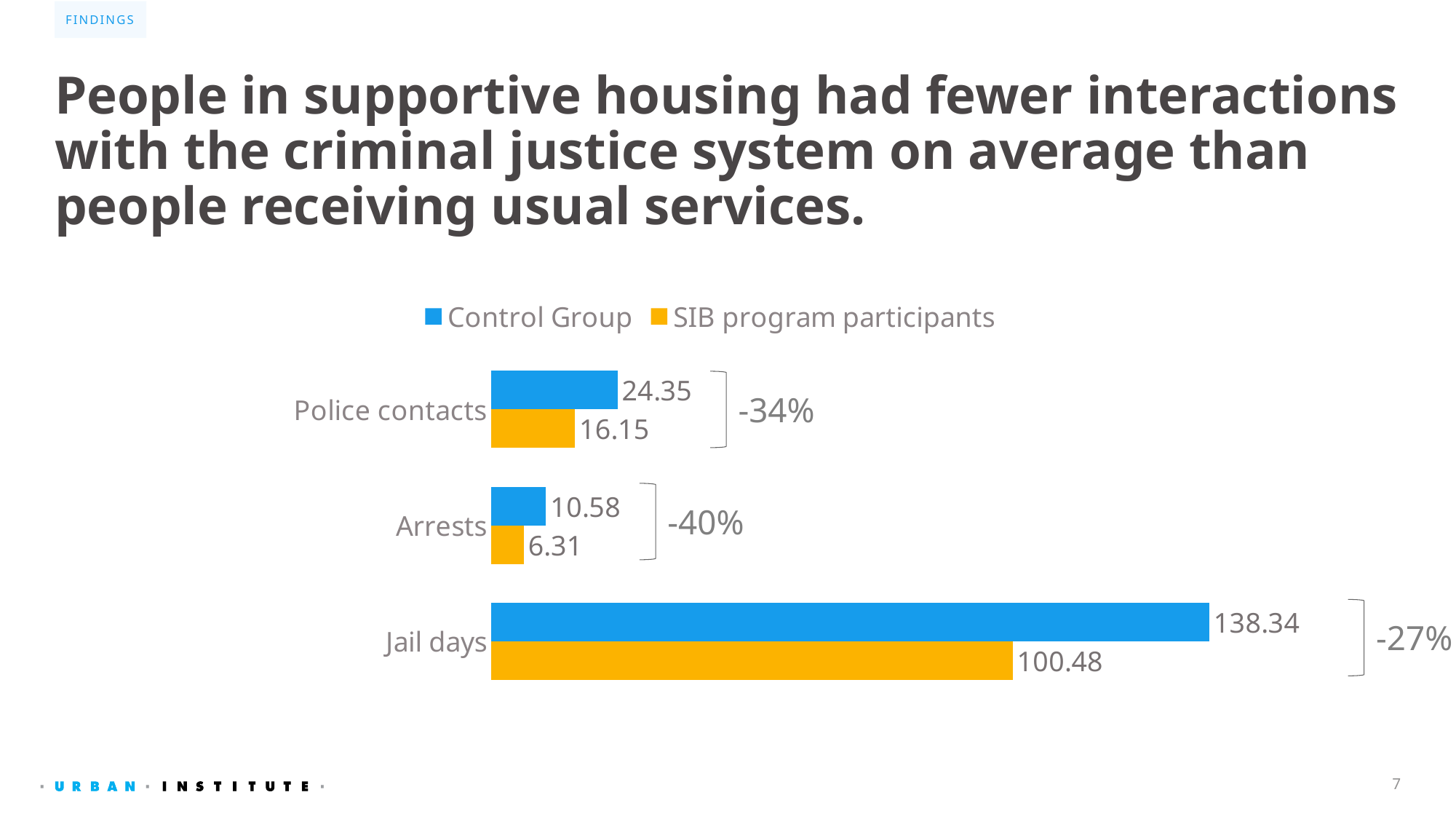
What is the Control Group value for Jail days? 138.34 Which category has the highest Control Group value? Jail days What is the difference between the Control Group and SIB program participants values for Jail days? 37.86 How many series does the legend list? 2 What is the Control Group value for Police contacts? 24.35 What kind of chart is shown on the slide? Bar chart What is the SIB program participants value for Arrests? 6.31 Which category has the lowest SIB program participants value? Arrests What is the difference between the Control Group and SIB program participants values for Arrests? 4.27 For Police contacts, which is larger: the Control Group value or the SIB program participants value? Control Group How many categories are shown on the chart? 3 What is the SIB program participants value for Jail days? 100.48